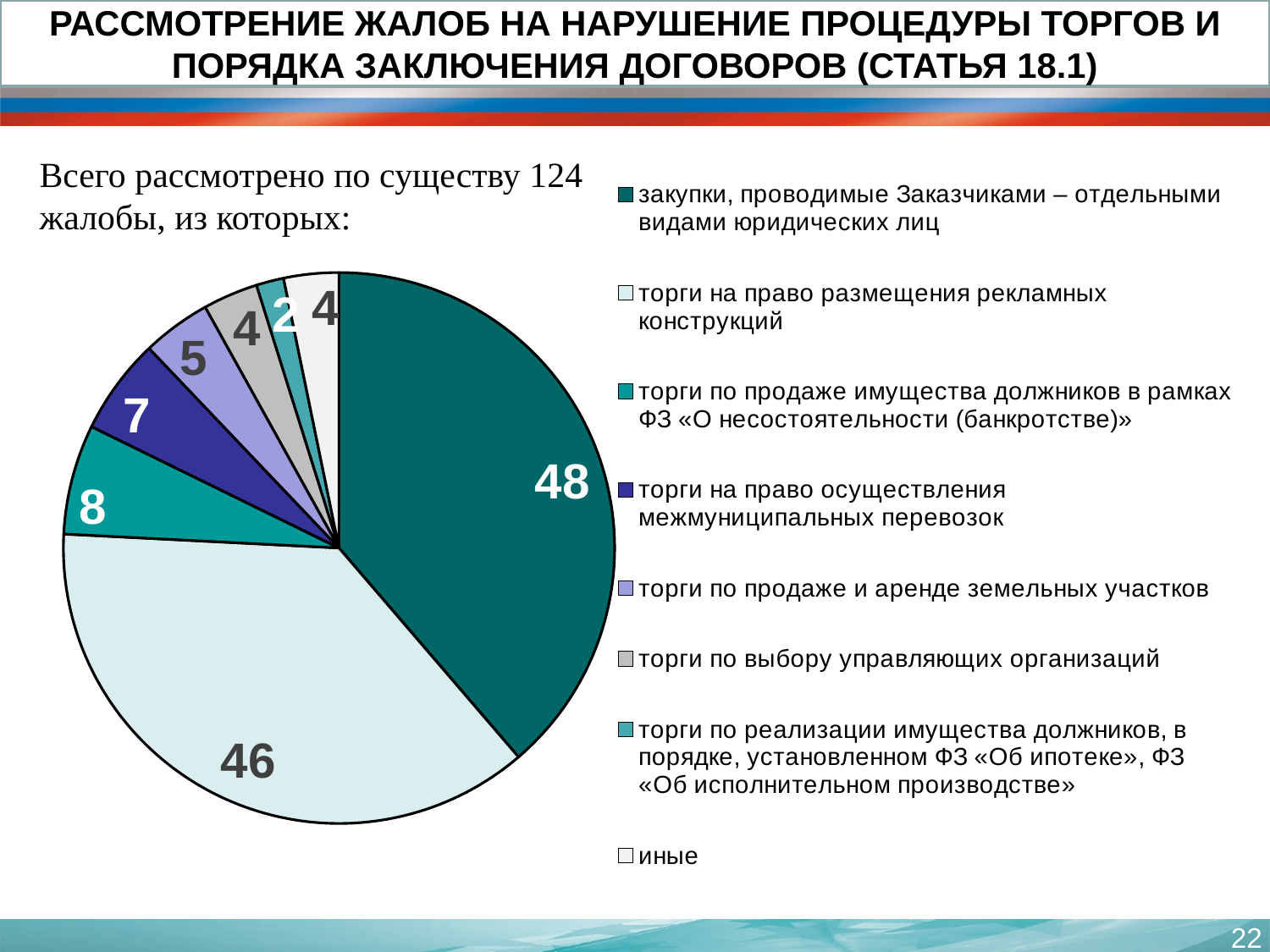
Which category has the largest slice of the pie? закупки, проводимые Заказчиками – отдельными видами юридических лиц How many slices does the pie chart have? 8 Which is larger: the value for «торги по продаже и аренде земельных участков» or the value for «торги по выбору управляющих организаций»? торги по продаже и аренде земельных участков What kind of chart is shown on the slide? pie chart What is the value for «закупки, проводимые Заказчиками – отдельными видами юридических лиц»? 48 What is the value for «торги на право размещения рекламных конструкций»? 46 What is the total number of complaints considered, as stated on the slide? 124 What is the value for «торги на право осуществления межмуниципальных перевозок»? 7 What is the difference between the values for «закупки, проводимые Заказчиками – отдельными видами юридических лиц» and «торги на право размещения рекламных конструкций»? 2 What is the value for «торги по продаже имущества должников в рамках ФЗ «О несостоятельности (банкротстве)»»? 8 How many entries does the legend of the pie chart list? 8 Which category has the smallest slice of the pie? торги по реализации имущества должников, в порядке, установленном ФЗ «Об ипотеке», ФЗ «Об исполнительном производстве»